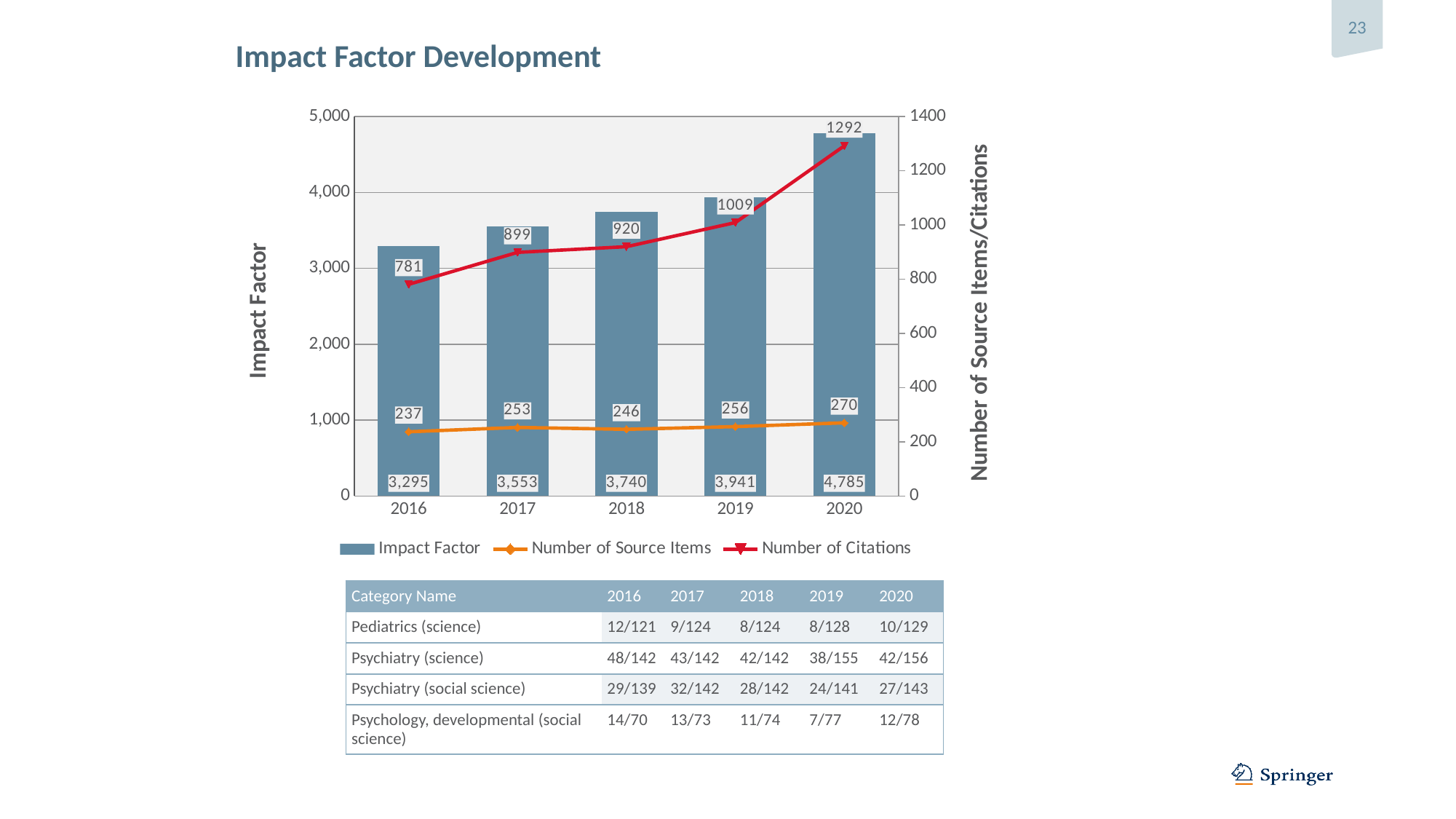
Does the Number of Citations rise or fall from 2016 to 2020? Rise What is the label of the right-hand vertical axis? Number of Source Items/Citations Which is larger, the Number of Source Items in 2017 or in 2018? 2017 What is the Number of Source Items for 2016? 237 How many series does the chart legend list? 3 Which year has the highest Impact Factor? 2020 How many years are shown on the x axis of the chart? 5 Which year has the lowest Number of Citations? 2016 What kind of chart is used to show the Impact Factor series? Bar chart What is the Number of Citations for 2019? 1009 What is the Impact Factor value for 2018? 3,740 What is the difference in Impact Factor between 2020 and 2019? 844